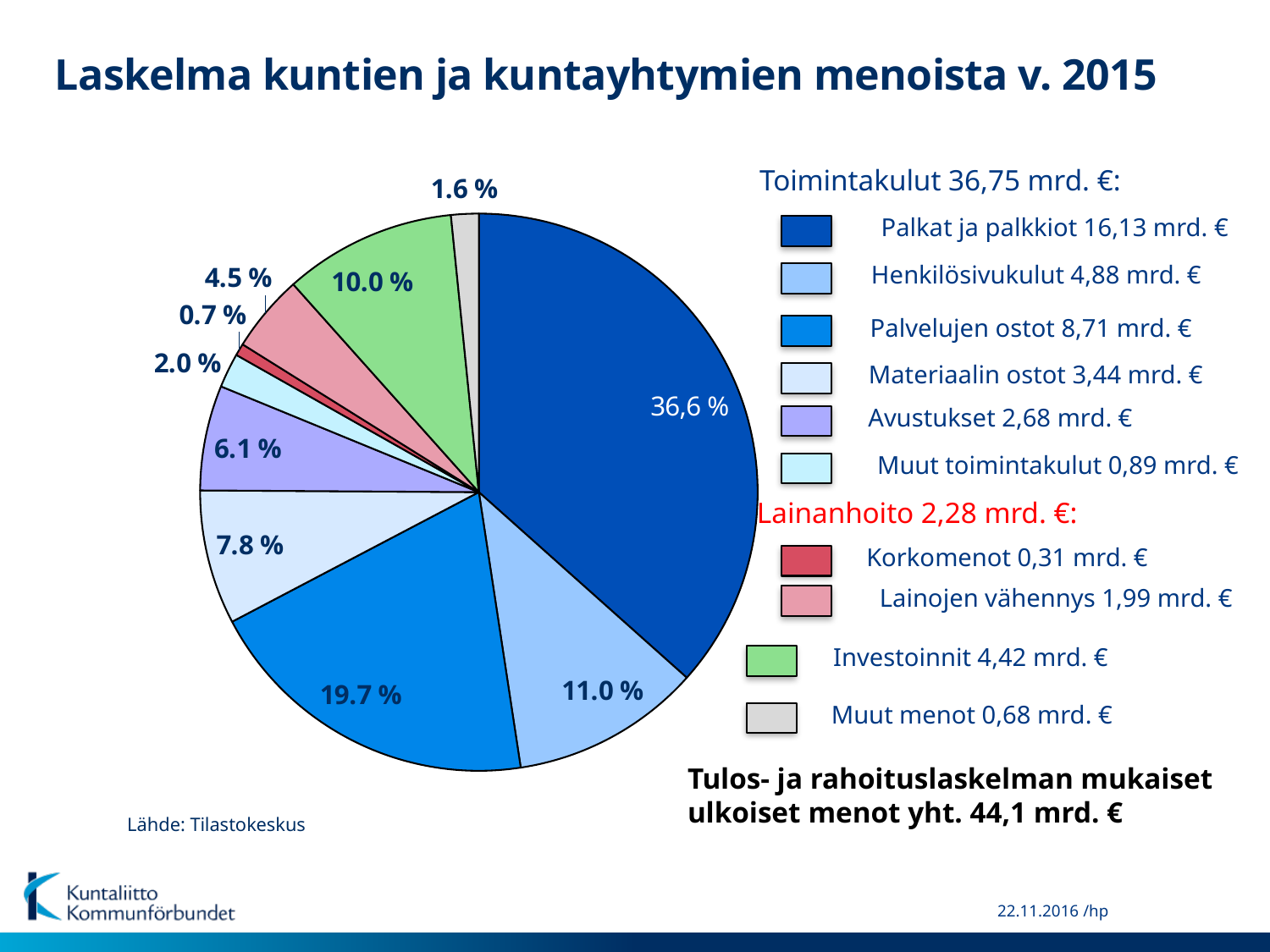
Which category has the smallest slice of the pie? Korkomenot What percentage is shown for the Palvelujen ostot slice? 19.7 % What percentage share of the pie does the largest slice (Palkat ja palkkiot) have? 36,6 % What is the difference in percentage points between the Palvelujen ostot slice (19.7 %) and the Henkilösivukulut slice (11.0 %)? 8.7 % What is the title of the slide? Laskelma kuntien ja kuntayhtymien menoista v. 2015 Which slice is larger, Materiaalin ostot or Avustukset? Materiaalin ostot Which category has the largest slice of the pie? Palkat ja palkkiot According to the legend, how many mrd. € are Lainojen vähennys? 1,99 mrd. € What percentage is shown for the Investoinnit slice? 10.0 % According to the legend, how many mrd. € are Henkilösivukulut? 4,88 mrd. € What kind of chart is shown on the slide? Pie chart How many slices does the pie chart have? 10